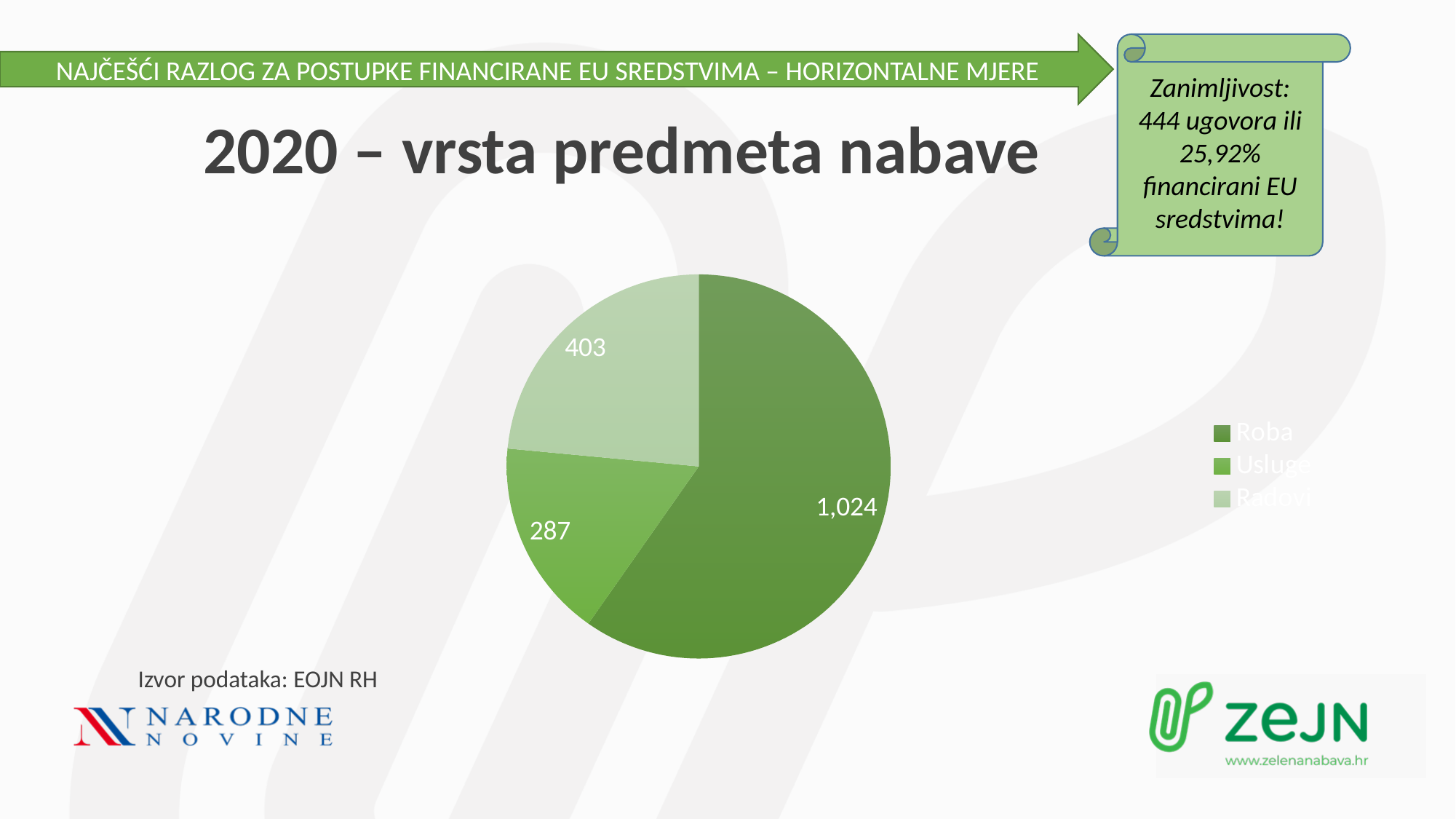
What kind of chart is shown on the slide? pie chart What is the difference between the values for Radovi and Usluge? 116 What is the value for Usluge in the pie chart? 287 Which is larger, the value for Radovi or the value for Usluge? Radovi What is the value for Roba in the pie chart? 1,024 What is the title of the slide above the pie chart? 2020 – vrsta predmeta nabave Which category has the smallest slice in the pie chart? Usluge Which category has the largest slice in the pie chart? Roba How many slices does the pie chart have? 3 What is the difference between the values for Roba and Radovi? 621 What is the value for Radovi in the pie chart? 403 What is the total of all slices in the pie chart? 1,714